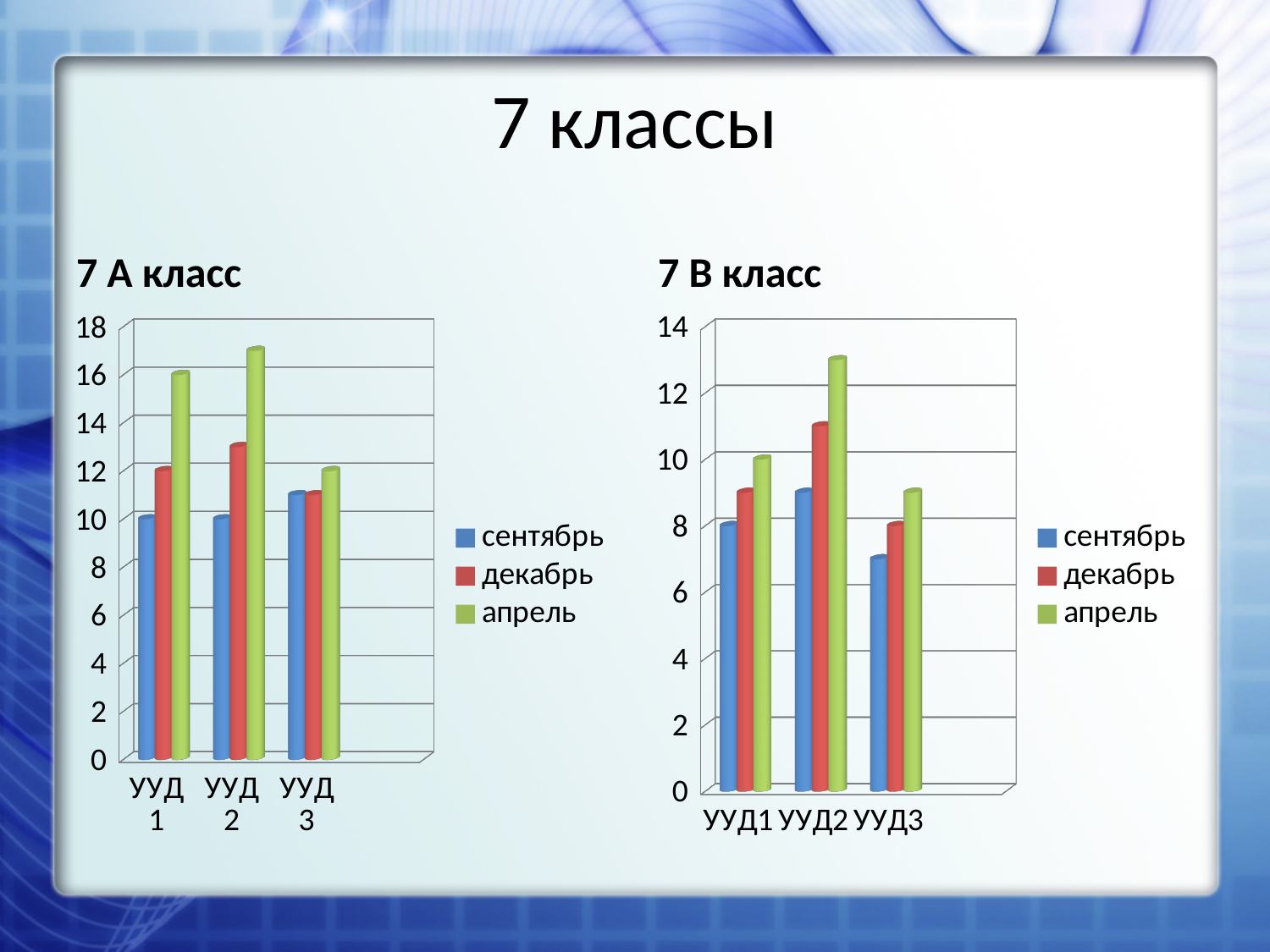
In the "7 В класс" chart, which category has the highest апрель value? УУД2 In the "7 А класс" chart, is the апрель value for УУД 1 greater or less than 14? greater How many categories are shown on the x axis of the "7 В класс" chart? 3 In the "7 А класс" chart, which category has the highest апрель value? УУД 2 How many series does the legend of the "7 В класс" chart list? 3 In the "7 В класс" chart, for УУД2, which is larger: декабрь or апрель? апрель What are the legend entries of the "7 А класс" chart? сентябрь, декабрь, апрель In the "7 А класс" chart, for УУД 1, do the values rise or fall from сентябрь to апрель? rise In the "7 В класс" chart, is the сентябрь value for УУД3 greater or less than 8? less In the "7 В класс" chart, which category has the lowest сентябрь value? УУД3 In the "7 А класс" chart, is the декабрь value for УУД 2 greater or less than 12? greater What kind of chart is the "7 А класс" chart? bar chart